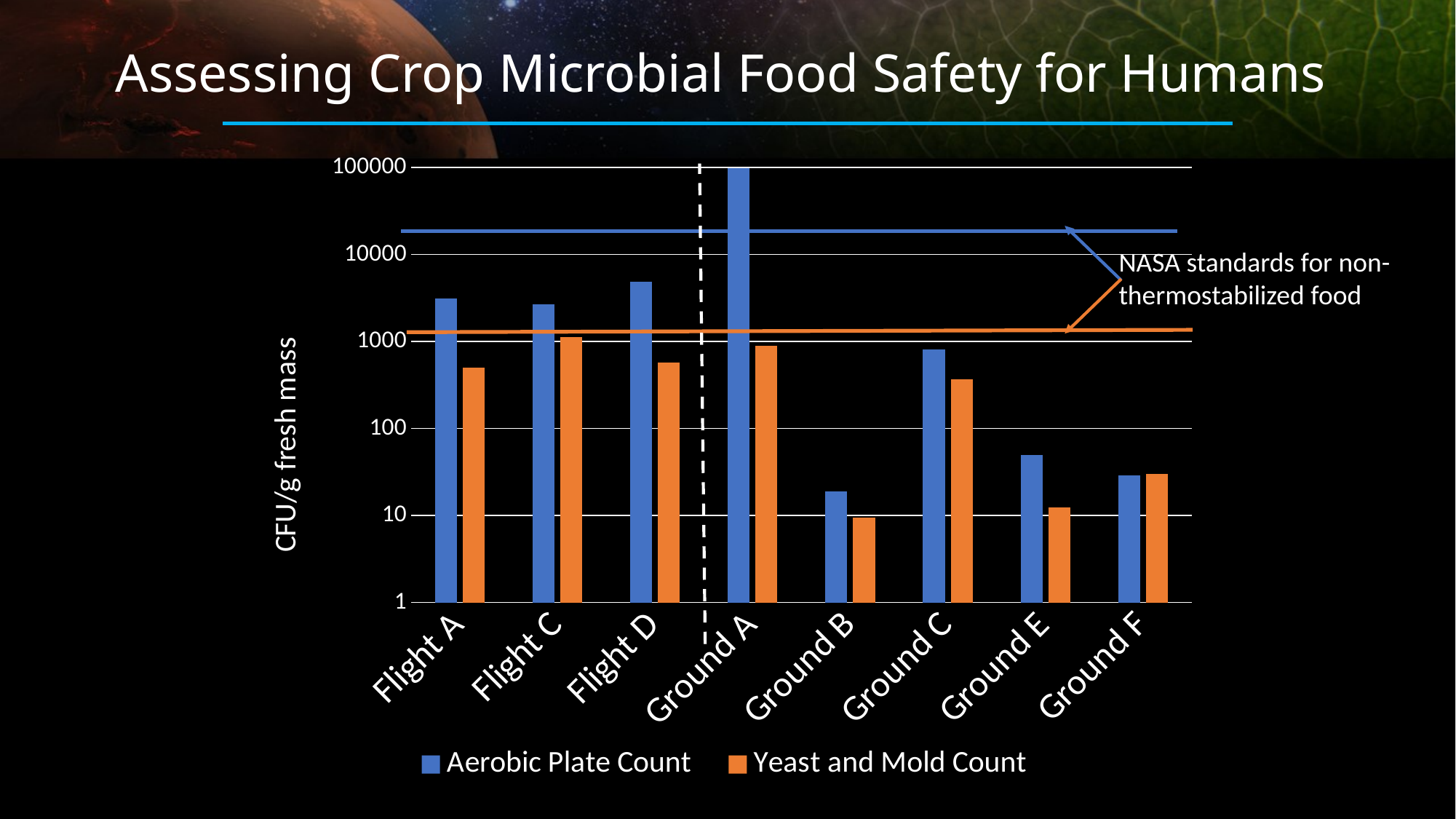
Which category has the lowest Yeast and Mold Count? Ground B For Flight A, which is larger: the Aerobic Plate Count or the Yeast and Mold Count? Aerobic Plate Count What kind of chart is shown on the slide? bar chart How many series does the chart's legend list? 2 Is the Aerobic Plate Count for Ground A greater or less than 10000? greater Is the Aerobic Plate Count for Ground C greater or less than 1000? less How many categories are shown on the x axis of the chart? 8 Is the Aerobic Plate Count for Flight A greater or less than 1000? greater Which category has the lowest Aerobic Plate Count? Ground B What is the label on the y axis of the chart? CFU/g fresh mass Which category has the highest Aerobic Plate Count? Ground A